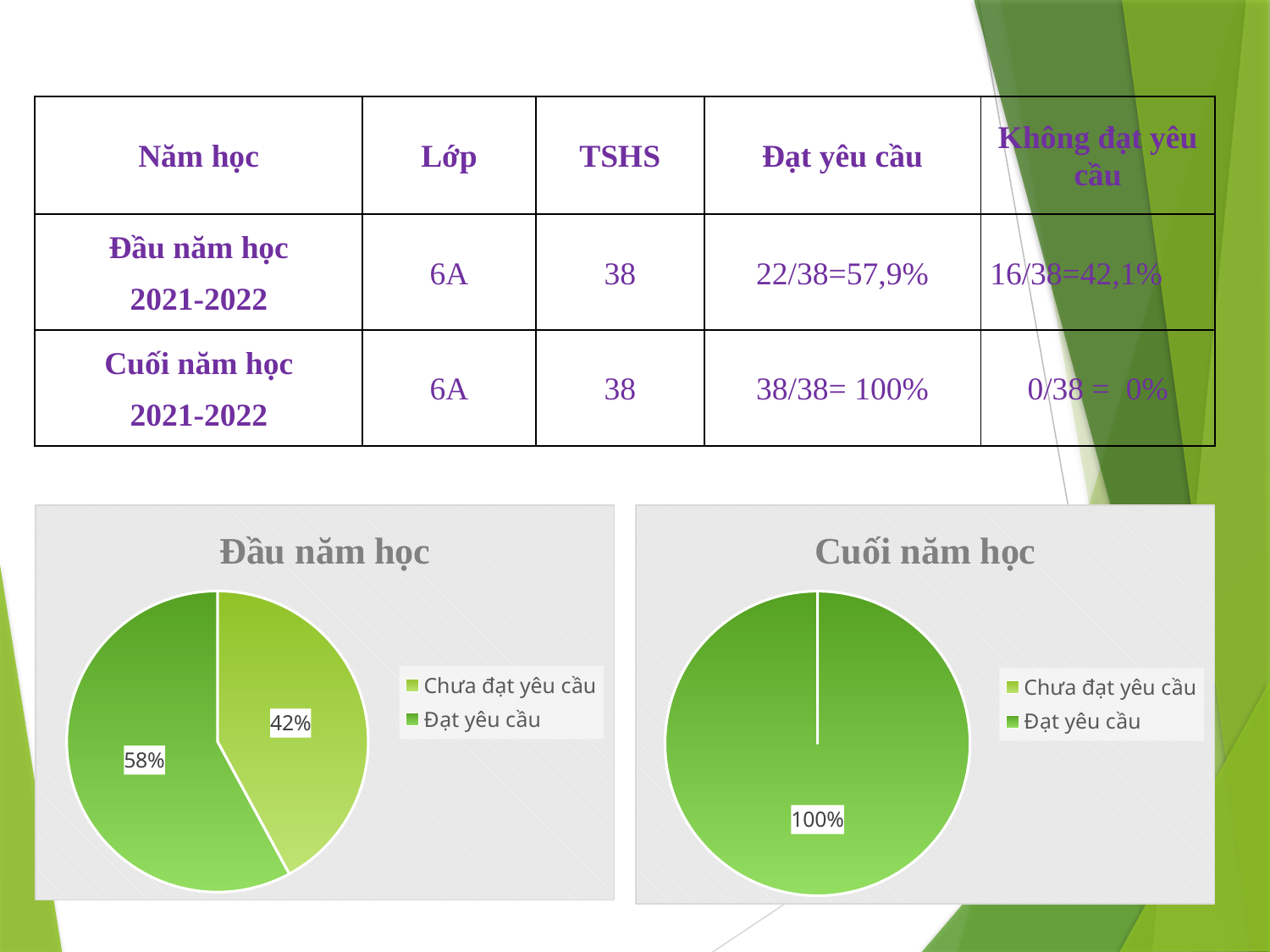
What is the title of the pie chart on the right of the slide? Cuối năm học In the "Đầu năm học" chart, which is larger: "Đạt yêu cầu" or "Chưa đạt yêu cầu"? Đạt yêu cầu How many entries does the legend of the "Cuối năm học" chart list? 2 In the "Đầu năm học" chart, which legend entry is shown in the darker green colour? Đạt yêu cầu In the "Đầu năm học" chart, which slice is the largest? Đạt yêu cầu In the "Đầu năm học" chart, what share of the pie is "Chưa đạt yêu cầu"? 42% In the "Đầu năm học" chart, what share of the pie is "Đạt yêu cầu"? 58% In the "Đầu năm học" chart, what is the difference between the "Đạt yêu cầu" and "Chưa đạt yêu cầu" shares? 16% What kind of chart is the "Đầu năm học" chart? pie chart In the "Cuối năm học" chart, what share of the pie is "Đạt yêu cầu"? 100% How many slices with data labels does the "Đầu năm học" chart have? 2 In the "Đầu năm học" chart, which slice is the smallest? Chưa đạt yêu cầu